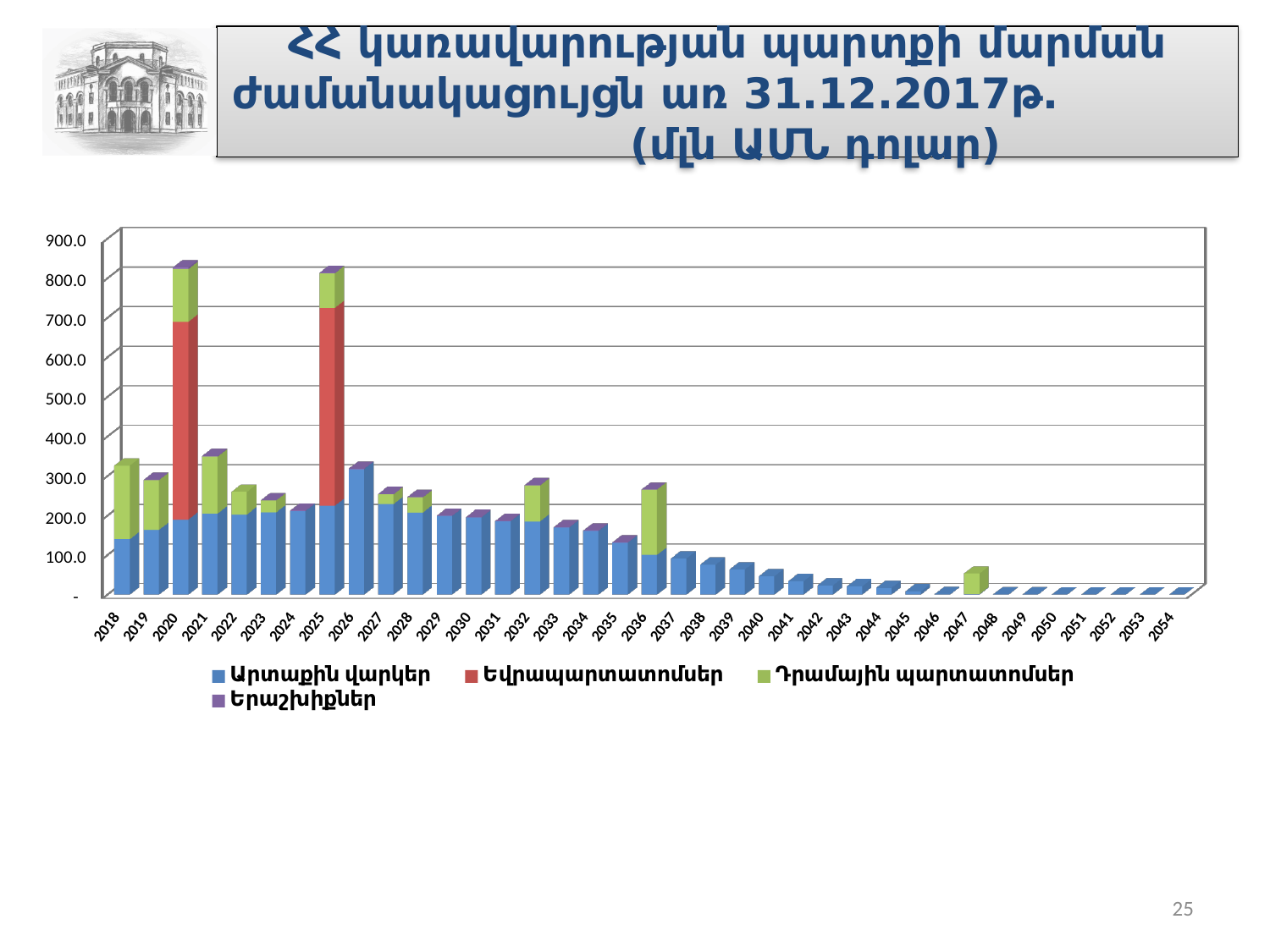
How many series does the chart legend list? 4 Is the total value for 2020 greater or less than 700? greater Do the total values rise or fall from 2037 to 2046? fall In which two years does the red series (Եվրապարտատոմսեր) appear in the chart? 2020 and 2025 Is the total value for 2025 greater or less than 700? greater Is the total value for 2018 greater or less than 400? less How many years (categories) are shown on the x axis of the chart? 37 Which year has the larger total bar, 2020 or 2021? 2020 What kind of chart is shown on the slide? Stacked bar chart Which year has the larger total bar, 2036 or 2037? 2036